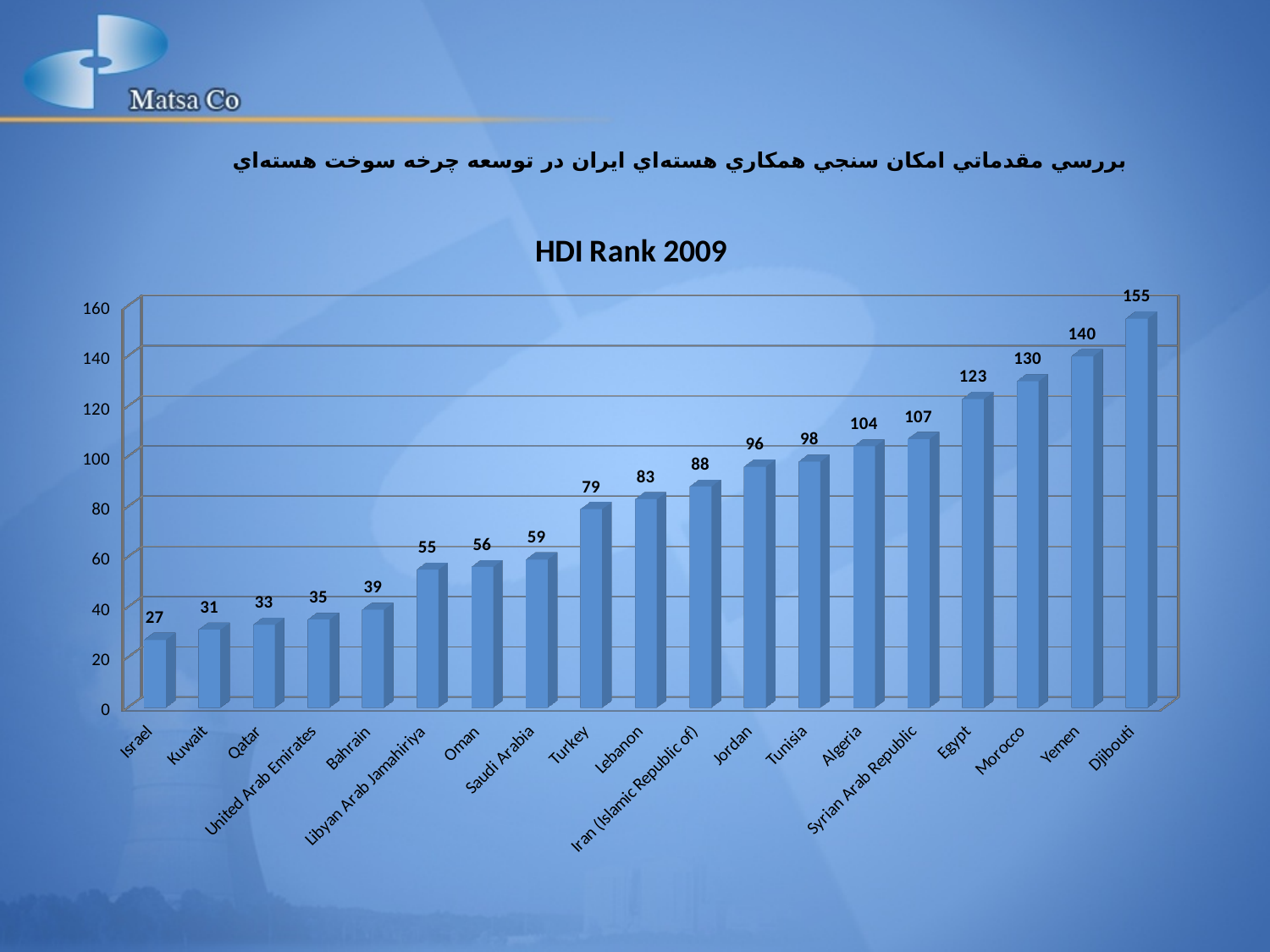
What is the HDI Rank 2009 value for Iran (Islamic Republic of)? 88 Do the values rise or fall from left to right along the x axis? Rise What is the title of the chart? HDI Rank 2009 What is the HDI Rank 2009 value for Turkey? 79 Which country has the highest value in the HDI Rank 2009 chart? Djibouti How many countries are shown in the HDI Rank 2009 chart? 19 Which country has the lowest value in the HDI Rank 2009 chart? Israel What is the difference between the values for Jordan and Lebanon? 13 What is the difference between the values for Djibouti and Israel? 128 What is the HDI Rank 2009 value for Egypt? 123 Which has a larger value, Morocco or Yemen? Yemen What kind of chart is shown on the slide? Bar chart